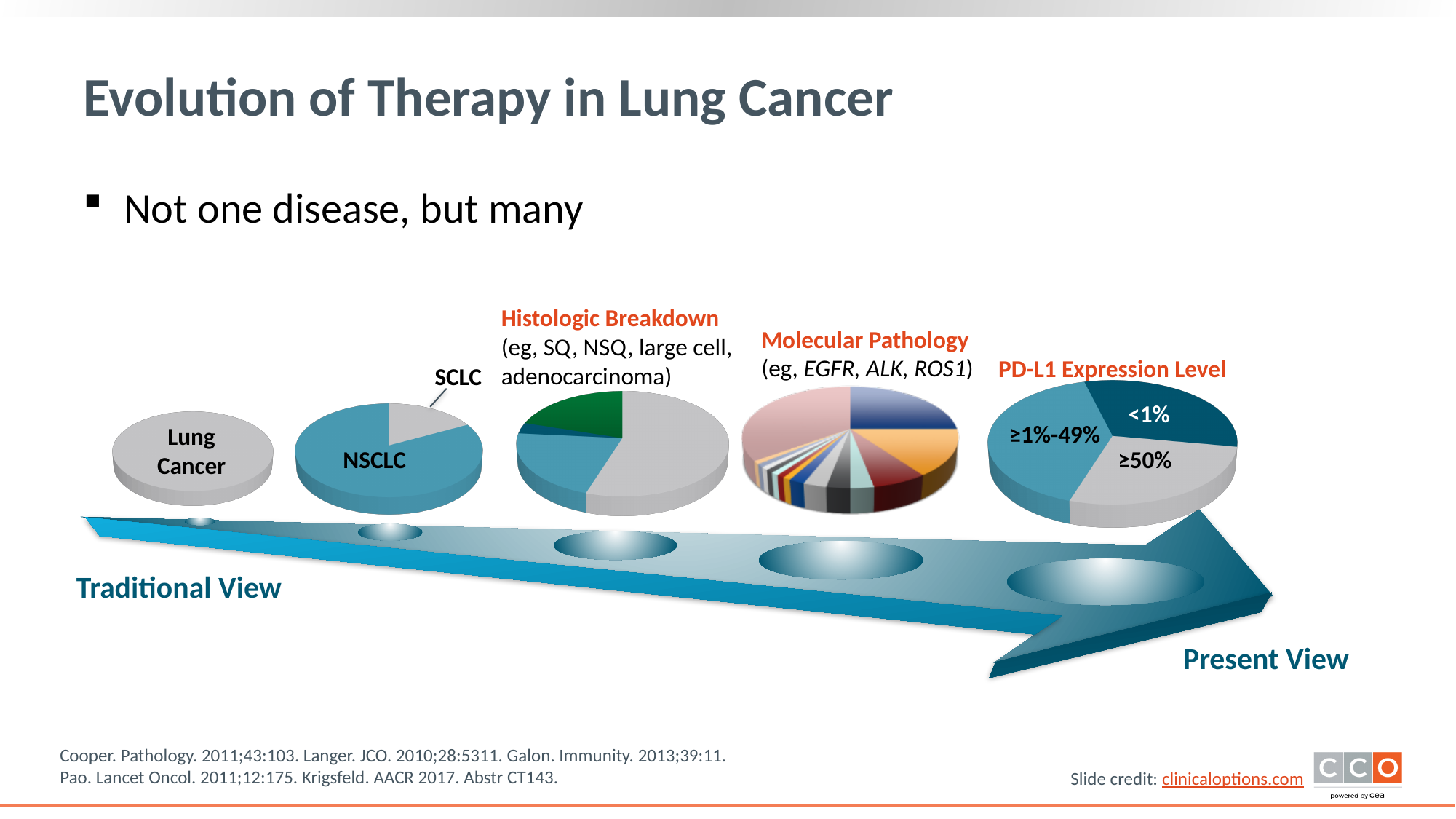
How many slices does the Histologic Breakdown pie chart have? 4 What kind of chart is the PD-L1 Expression Level chart? Pie chart What kind of chart is used to show the split between NSCLC and SCLC? Pie chart In the NSCLC/SCLC pie chart, which category has the smallest slice? SCLC What are the three categories labeled in the PD-L1 Expression Level pie chart? <1%, ≥1%-49%, ≥50% In the NSCLC/SCLC pie chart, which slice is larger, NSCLC or SCLC? NSCLC Which pie chart on the slide has the most slices? Molecular Pathology In the Histologic Breakdown pie chart, is the green slice larger or smaller than the grey slice? Smaller How many slices does the PD-L1 Expression Level pie chart have? 3 How many slices does the NSCLC/SCLC pie chart have? 2